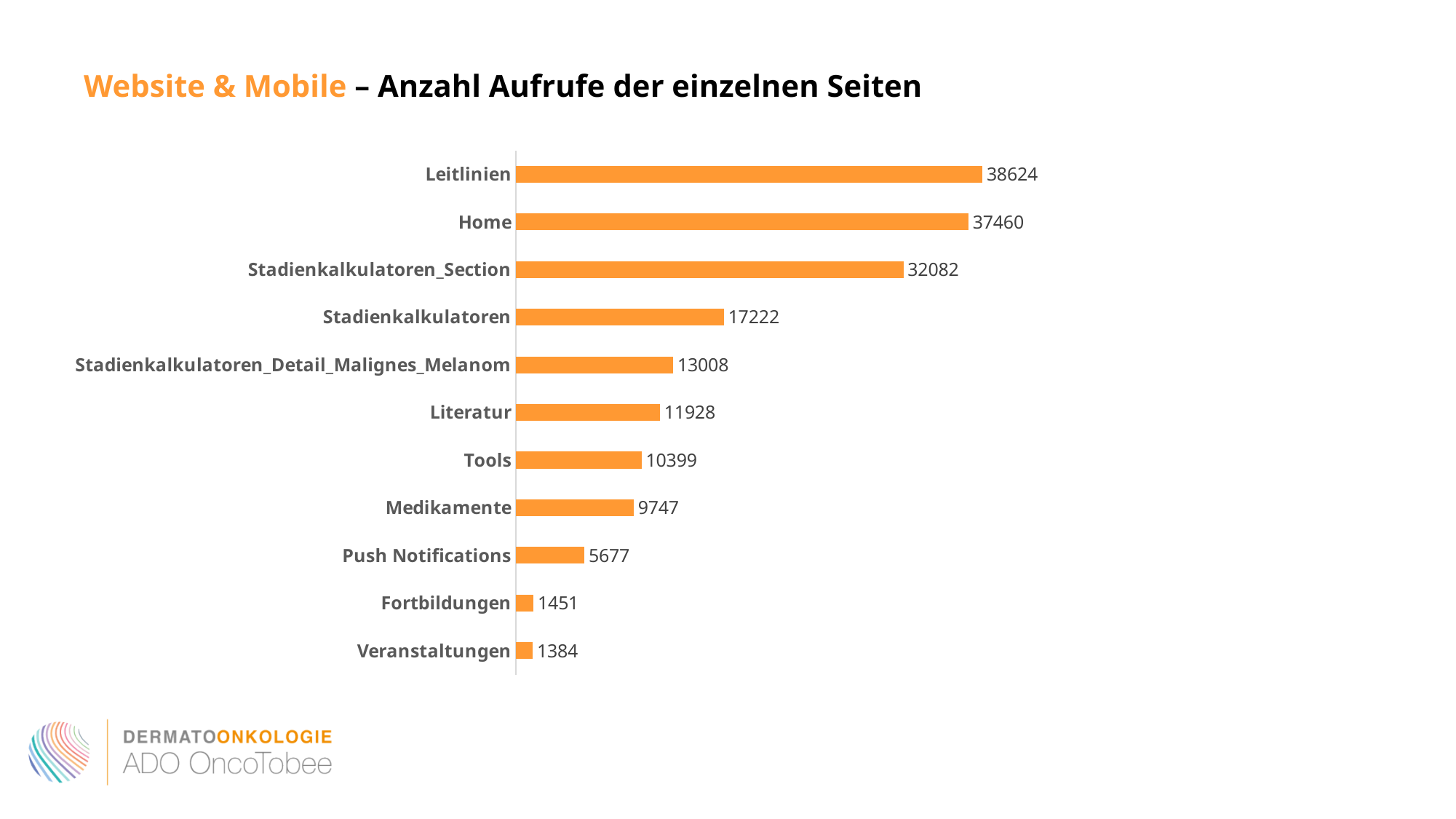
Which page has the lowest number of views? Veranstaltungen What is the value shown for Stadienkalkulatoren_Detail_Malignes_Melanom? 13008 What kind of chart is shown on the slide? Bar chart Which has a larger value, Medikamente or Push Notifications? Medikamente What is the value shown for Push Notifications? 5677 How many pages (categories) are shown in the chart? 11 What colour are the bars in the chart? Orange What is the difference between the values for Stadienkalkulatoren_Section and Stadienkalkulatoren? 14860 Which has a larger value, Literatur or Tools? Literatur Which page has the highest number of views? Leitlinien What is the difference between the values for Leitlinien and Home? 1164 What is the number of page views for Leitlinien? 38624